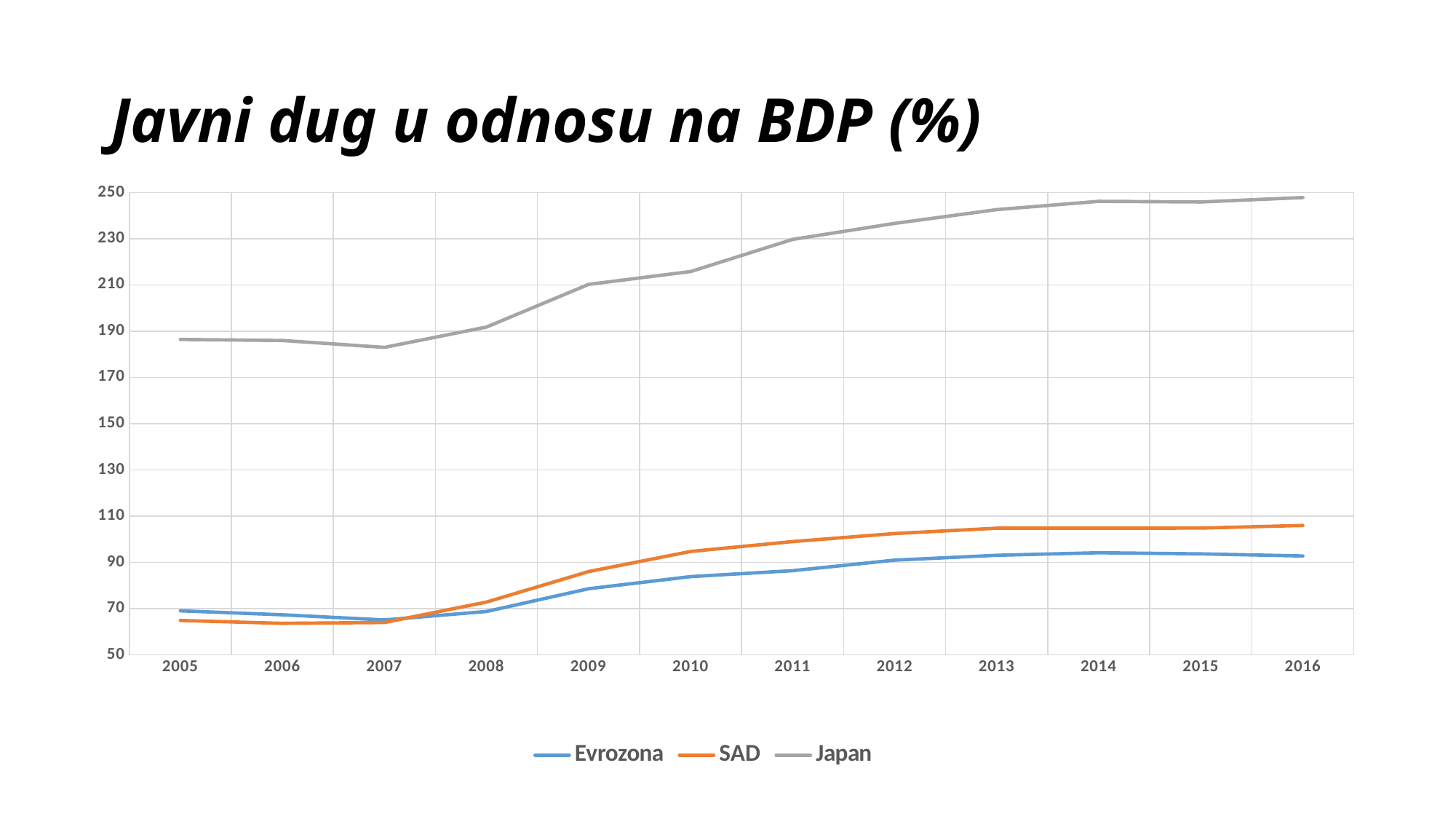
Which series has the lowest value in 2016? Evrozona What is the title of the chart? Javni dug u odnosu na BDP (%) Is the value for SAD in 2007 greater or less than 70? less Is the value for Japan in 2016 greater or less than 230? greater Is the value for SAD in 2016 greater or less than 90? greater Which series is drawn in orange? SAD How many years are plotted along the x axis? 12 Does the Japan line rise or fall from 2007 to 2016? rise In 2016, which is larger, the value for SAD or the value for Evrozona? SAD How many series does the legend list? 3 Which series has the highest values across all years? Japan What kind of chart is shown on the slide? line chart